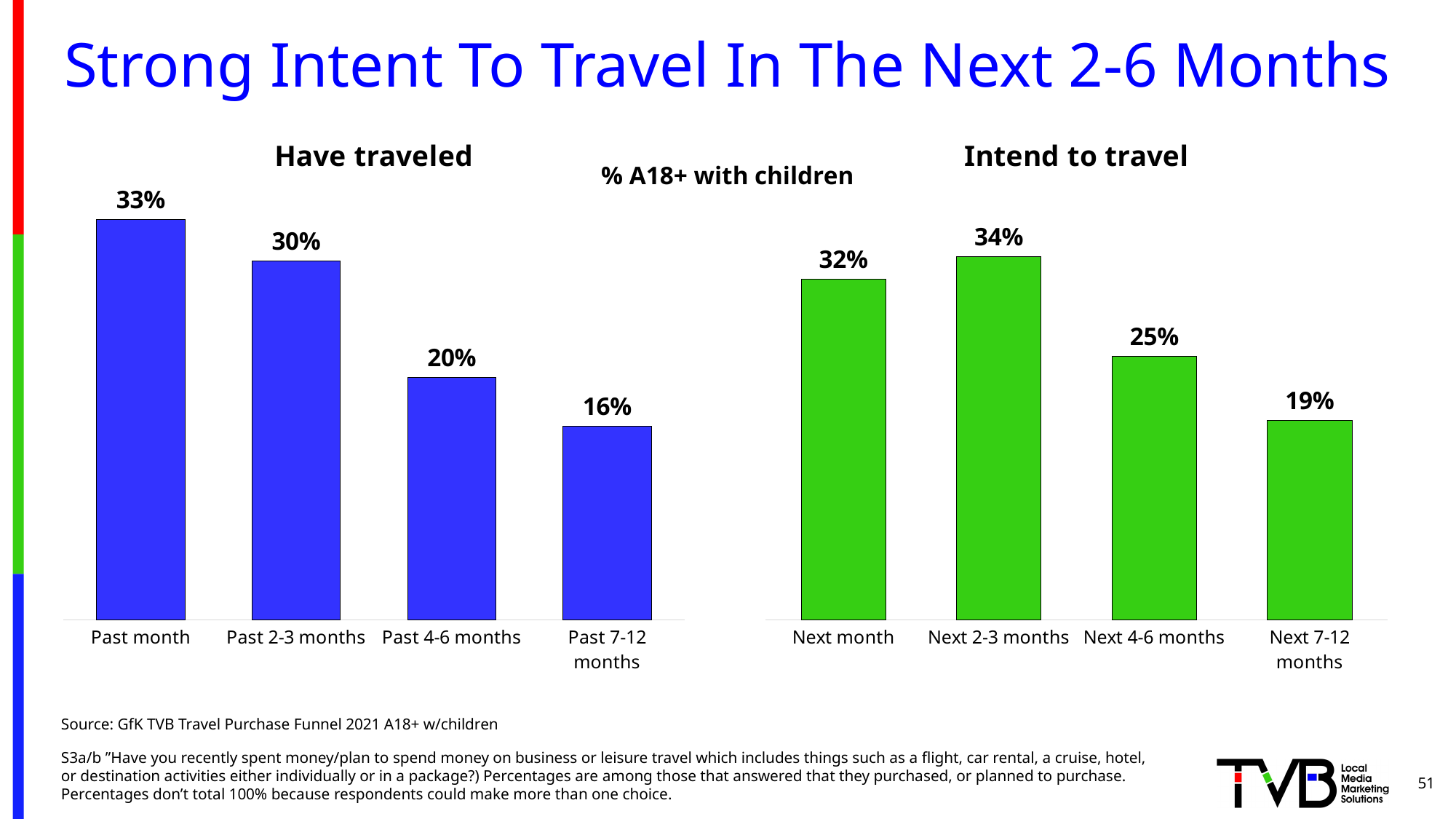
What kind of chart is the 'Intend to travel' chart? Bar chart How many categories does the 'Have traveled' chart show? 4 In the 'Intend to travel' chart, what is the difference between Next 2-3 months and Next 7-12 months? 15% What colour are the bars in the 'Intend to travel' chart? Green In the 'Have traveled' chart, which category has the lowest value? Past 7-12 months In the 'Have traveled' chart, what is the difference between Past month and Past 7-12 months? 17% In the 'Intend to travel' chart, which category has the highest value? Next 2-3 months In the 'Have traveled' chart, do the values rise or fall from Past month to Past 7-12 months? Fall In the 'Have traveled' chart, what is the value for Past month? 33% Which is larger: Past 2-3 months in the 'Have traveled' chart or Next 2-3 months in the 'Intend to travel' chart? Next 2-3 months In the 'Intend to travel' chart, what is the value for Next month? 32% In the 'Intend to travel' chart, what is the value for Next 4-6 months? 25%